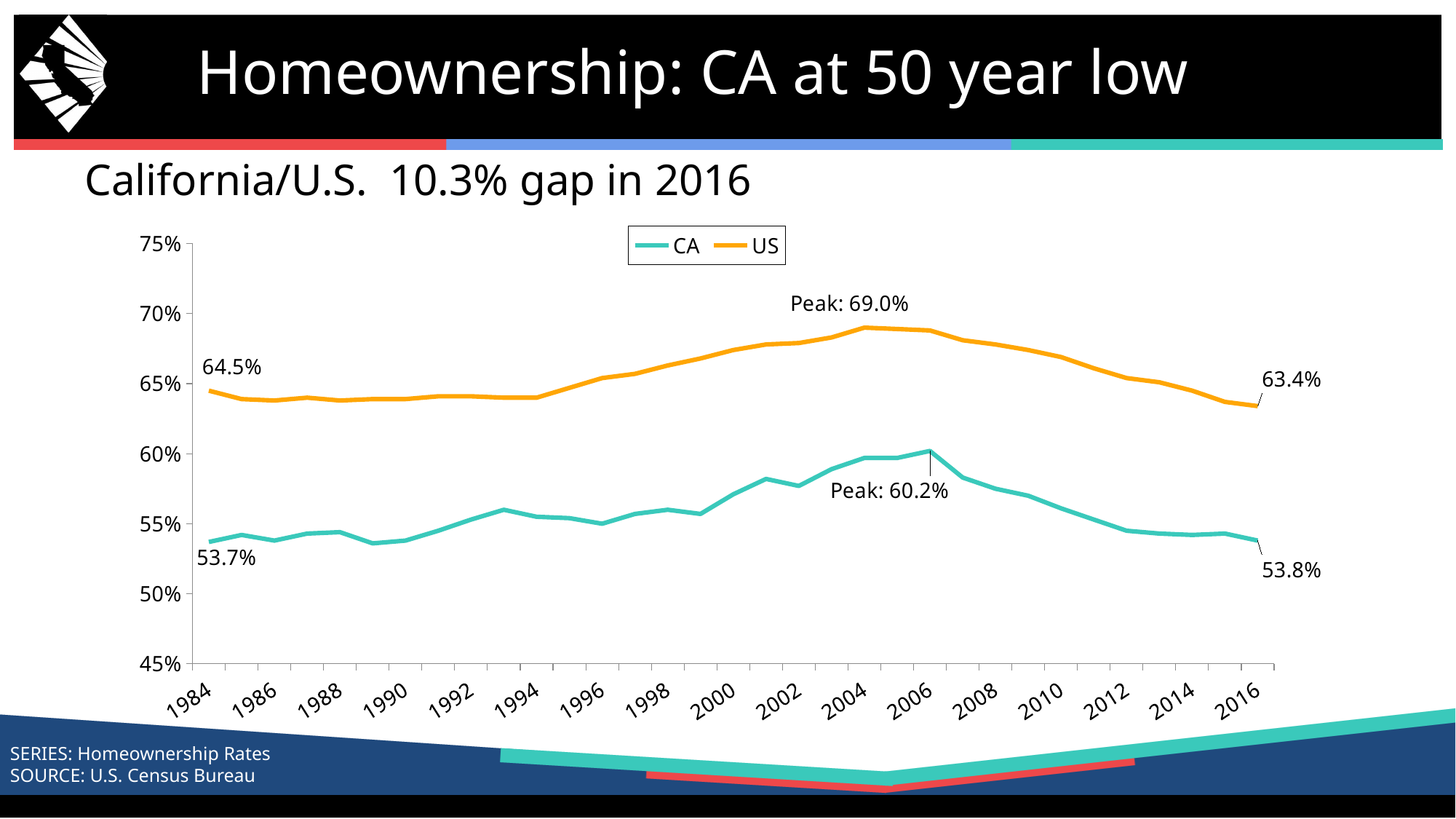
How many series does the legend list? 2 What is the difference between the US and CA homeownership rates in 1984? 10.8% What kind of chart is shown on the slide? line chart What was the CA homeownership rate in 1984? 53.7% Is the value for CA in 2010 greater or less than 55%? greater What colour is the US line in the chart? orange What is the difference between the US peak and the CA peak? 8.8% What was the peak value of the US series? 69.0% Does the US series rise or fall from 2004 to 2016? fall What was the US homeownership rate in 2016? 63.4% Which series had the higher value in 2016, CA or US? US What was the peak value of the CA series? 60.2%